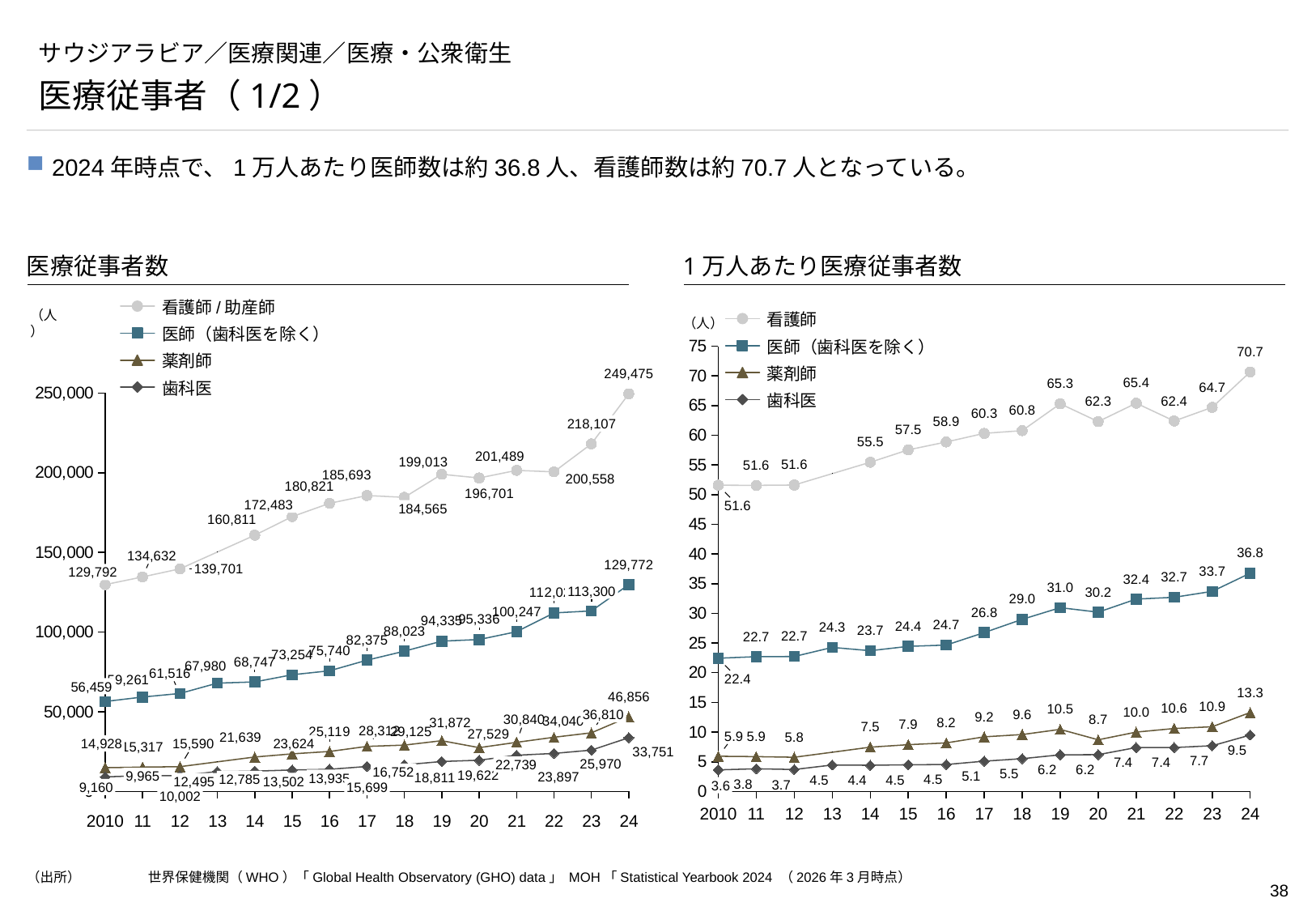
In the left chart (医療従事者数), what is the value for 看護師/助産師 in 2024? 249,475 In the left chart (医療従事者数), what is the value for 歯科医 in 2024? 33,751 In the right chart (1万人あたり医療従事者数), what is the difference between the 看護師 value in 2024 and in 2010? 19.1 In the right chart (1万人あたり医療従事者数), what is the value for 看護師 in 2024? 70.7 In the left chart (医療従事者数), does the 看護師/助産師 series generally rise or fall from 2010 to 2024? rise In the left chart (医療従事者数), what is the value for 医師（歯科医を除く） in 2010? 56,459 In the right chart (1万人あたり医療従事者数), which series has the highest value in 2024? 看護師 In the right chart (1万人あたり医療従事者数), what is the value for 医師（歯科医を除く） in 2024? 36.8 How many years are plotted along the x axis of the left chart (医療従事者数)? 15 What kind of chart is the left chart (医療従事者数)? line chart In the right chart (1万人あたり医療従事者数), which is larger in 2024: 薬剤師 or 歯科医? 薬剤師 How many series does the legend of the right chart (1万人あたり医療従事者数) list? 4